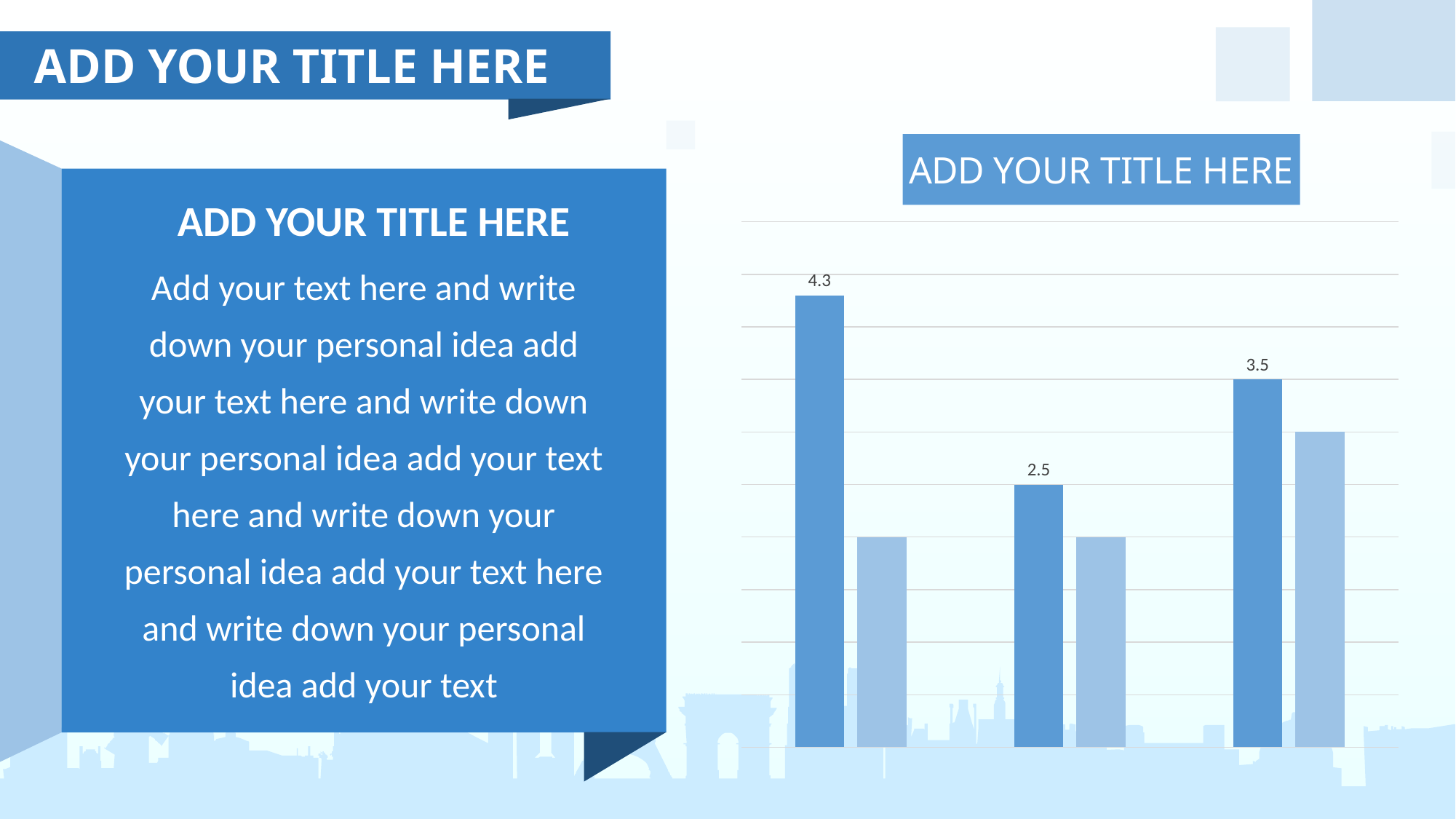
How many bars are in each group of the chart? 2 Which group has the lowest dark blue bar? the second group What is the value labelled on the dark blue bar in the second group? 2.5 In the first group, which bar is taller, the dark blue or the light blue one? the dark blue bar What is the difference between the dark blue bar values in the third and second groups? 1 What kind of chart is shown on the right of the slide? bar chart What is the difference between the dark blue bar values in the first and second groups? 1.8 What is the value labelled on the dark blue bar in the third group? 3.5 Which group has the highest dark blue bar? the first group How many groups of bars does the chart show? 3 What is the title shown above the chart? ADD YOUR TITLE HERE What is the value labelled on the dark blue bar in the first group? 4.3